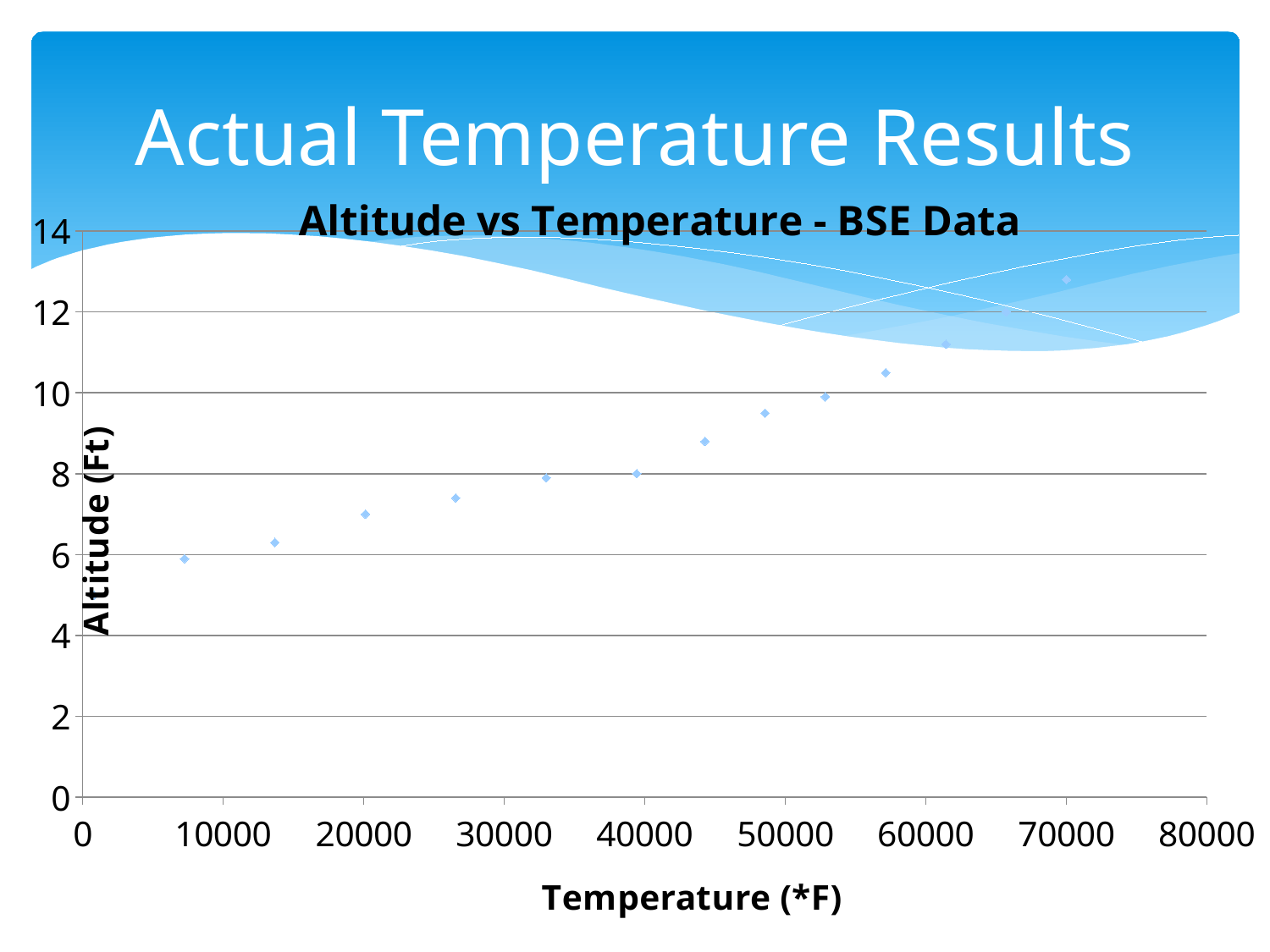
Is the altitude value for the leftmost point (near 7000 on the x axis) greater or less than 8? less Which point has the highest altitude value: the one near 70000 or the one near 7000 on the x axis? the one near 70000 What is the label of the vertical axis? Altitude (Ft) Is the altitude value for the point near 48500 on the x axis greater or less than 10? less Is the altitude value for the point near 20000 on the x axis greater or less than 8? less What is the title of the chart? Altitude vs Temperature - BSE Data What kind of chart is shown on the slide? scatter chart Do the altitude values rise or fall as temperature increases along the x axis? rise